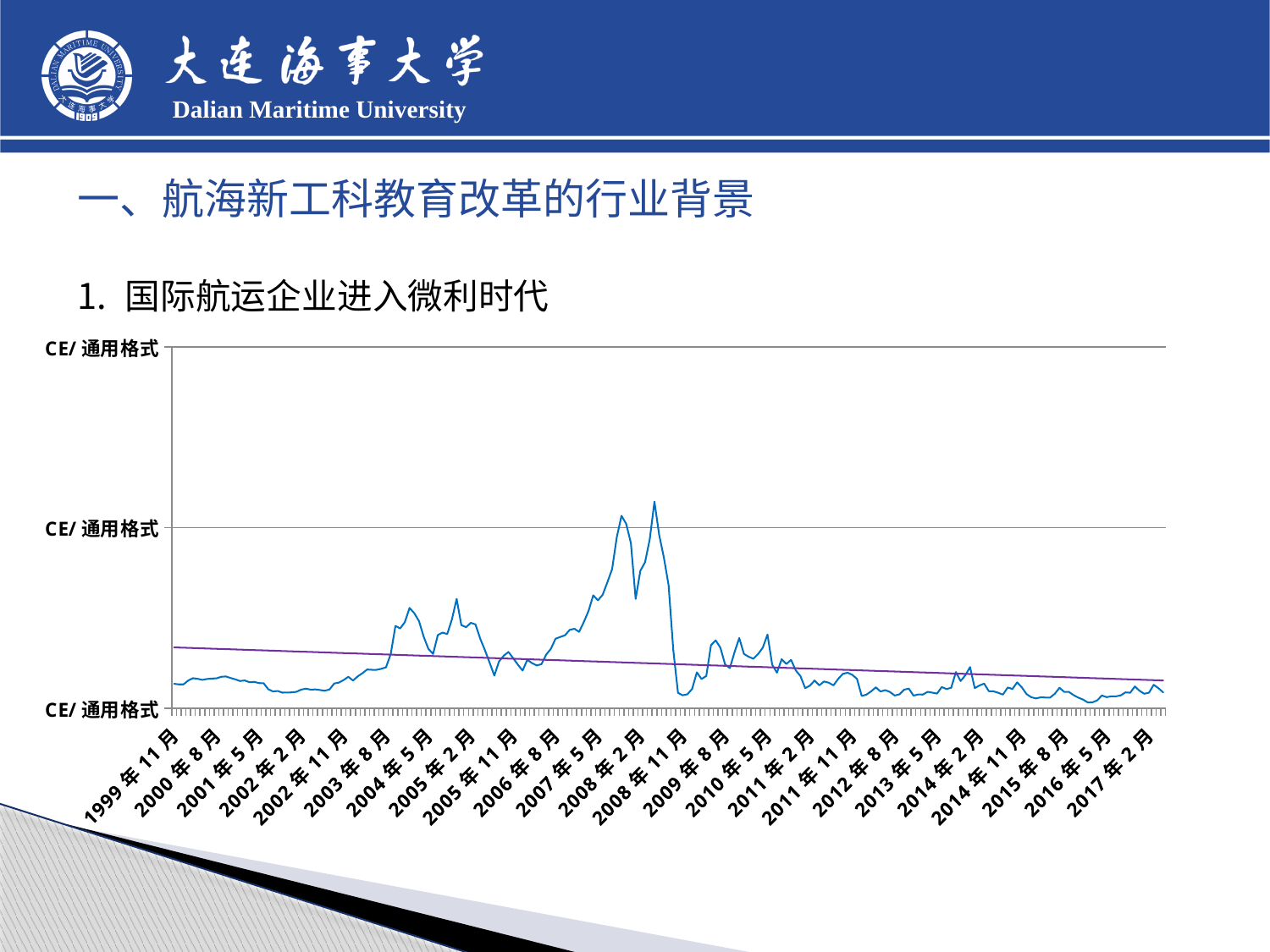
After its peak in 2008, does the blue line rise or fall sharply toward 2008年11月? fall What is the last label on the x axis of the chart? 2017年2月 What kind of chart is shown on the slide? line chart What is the first label on the x axis of the chart? 1999年11月 Is the blue line higher around 2008年2月 or around 2017年2月? 2008年2月 How many labels are shown along the x axis of the chart? 24 Is the blue line higher around 2004年5月 or around 2000年8月? 2004年5月 In which year does the blue line reach its highest point? 2008 Does the straight purple trend line rise or fall from left to right across the chart? fall